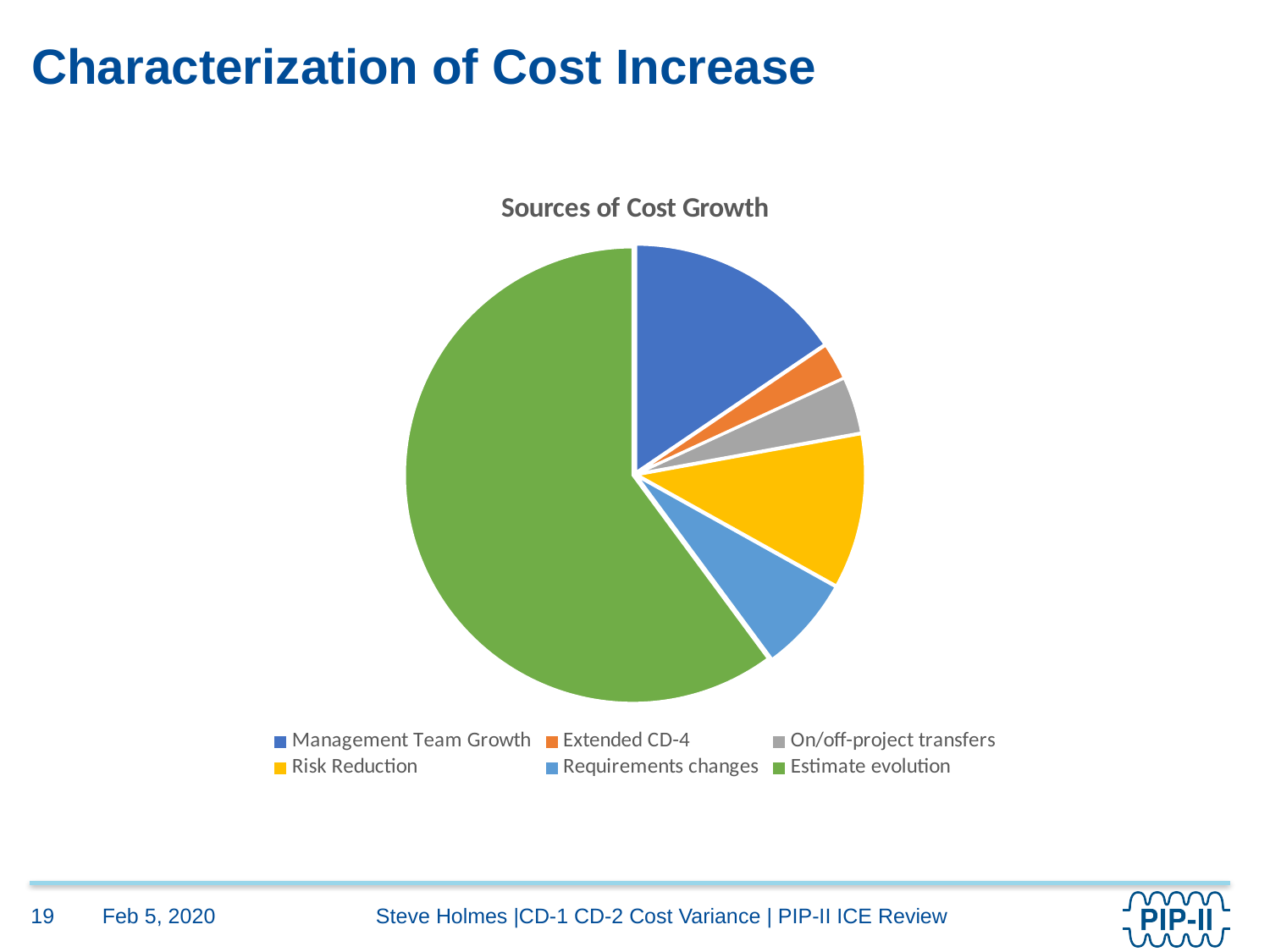
Which is larger, the slice for Risk Reduction or the slice for Requirements changes? Risk Reduction Which is larger, the slice for Estimate evolution or the slice for Management Team Growth? Estimate evolution Which source accounts for the largest share of cost growth? Estimate evolution Does the Estimate evolution slice make up more or less than half of the pie? more Which colour represents Estimate evolution in the pie chart? green What is the title of the chart? Sources of Cost Growth What kind of chart is shown on the slide? pie chart How many entries does the legend list? 6 How many slices does the pie chart have? 6